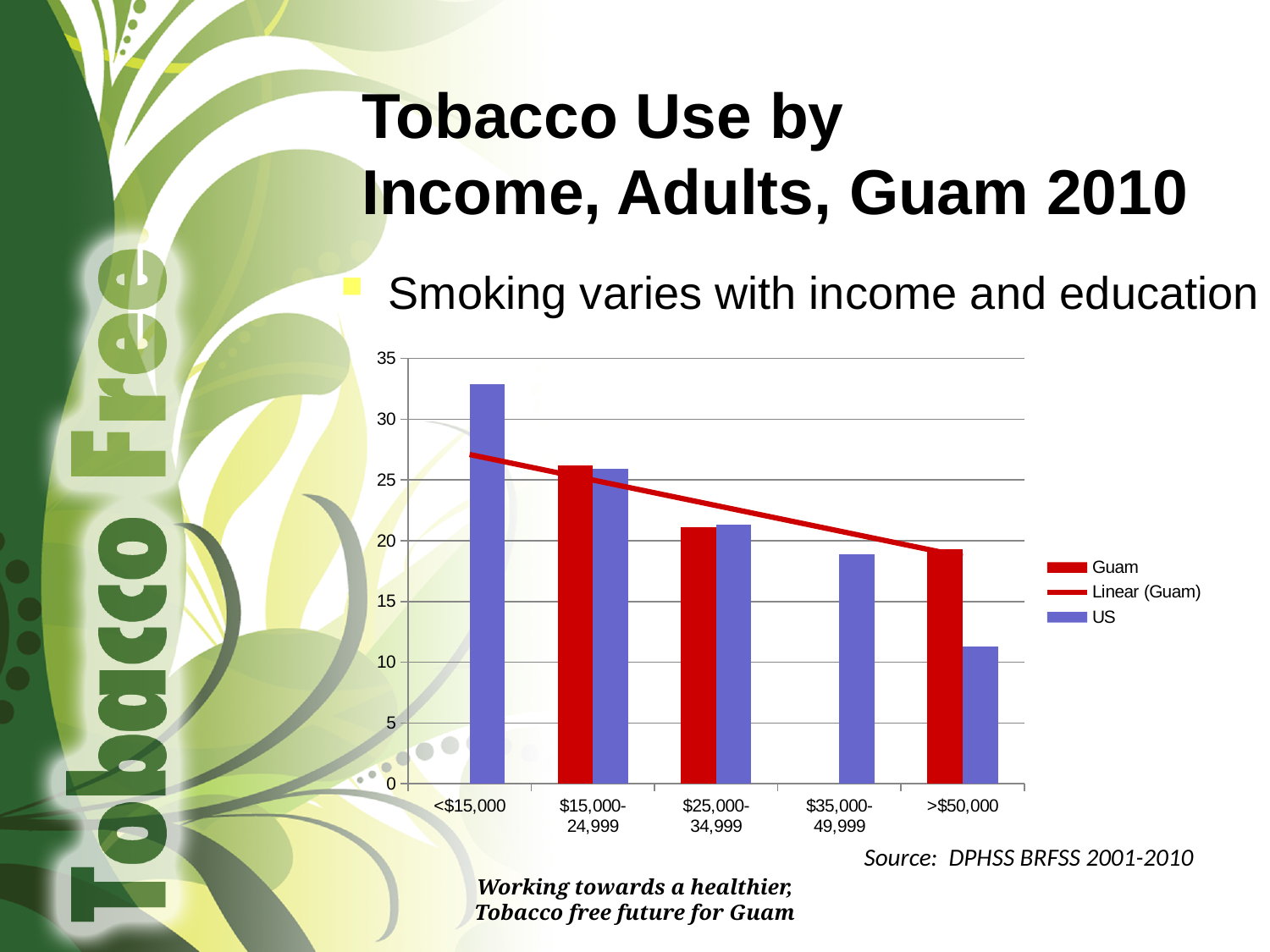
Is the Guam value for $15,000-24,999 greater or less than 25? greater For the >$50,000 category, which is larger, the Guam value or the US value? Guam What colour are the Guam bars? red What kind of chart is shown on the slide? bar chart Which income category has the lowest US value? >$50,000 Which income category has the highest US value? <$15,000 Do the US values rise or fall as income increases along the x axis? fall How many entries does the legend list? 3 Is the US value for $35,000-49,999 greater or less than 15? greater Is the US value for <$15,000 greater or less than 30? greater How many income categories are shown on the x axis? 5